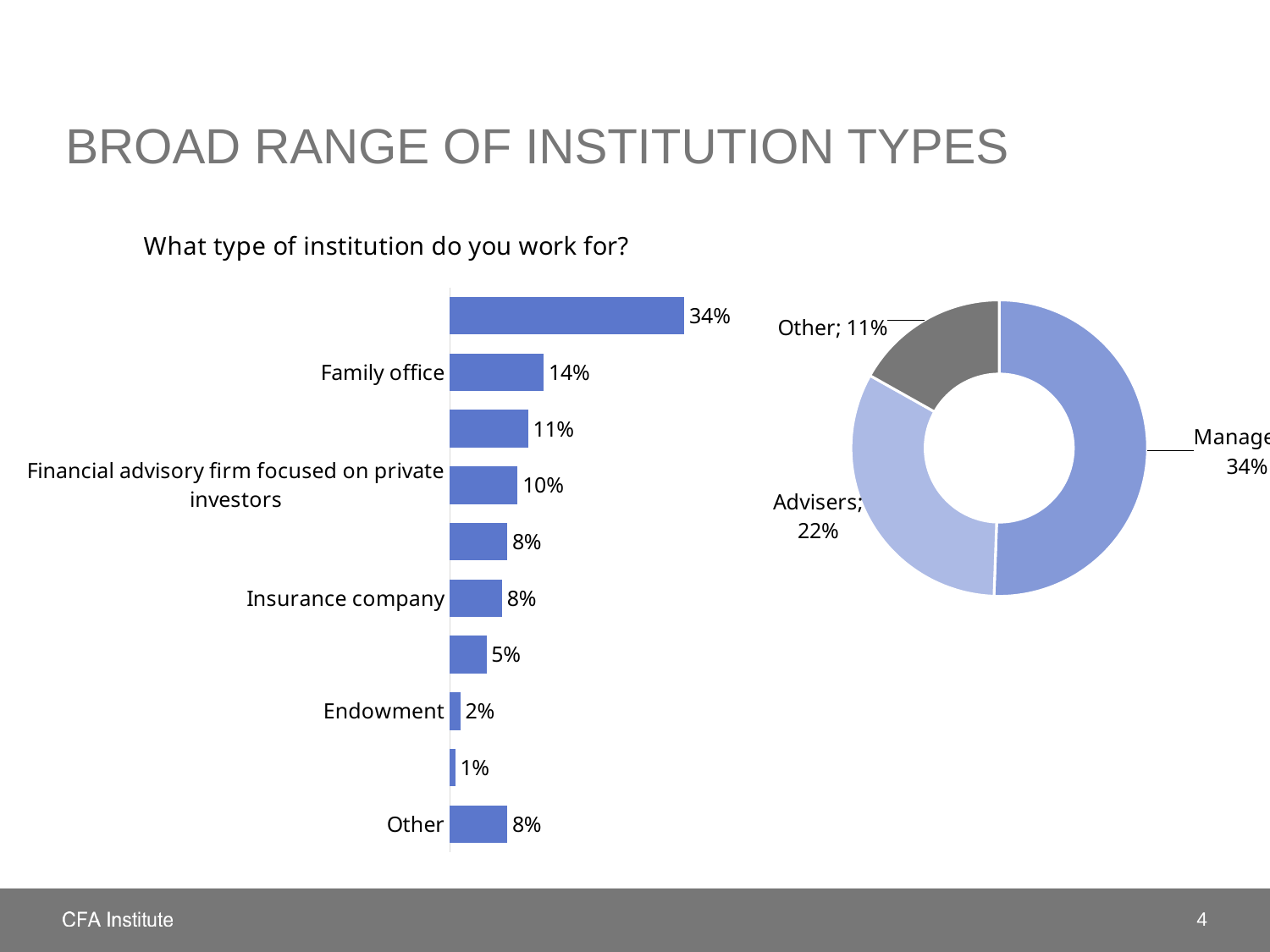
In the bar chart on the left, which is larger: Family office or Insurance company? Family office In the doughnut chart on the right, which is larger: Advisers or Other? Advisers In the doughnut chart on the right, what percentage is shown for Advisers? 22% In the bar chart on the left, what percentage is shown for Family office? 14% In the bar chart on the left, what percentage is shown for Financial advisory firm focused on private investors? 10% In the bar chart on the left, what percentage is shown for Insurance company? 8% In the bar chart on the left, what is the smallest value shown on any bar? 1% How many bars are plotted in the bar chart on the left? 10 In the bar chart on the left, how many percentage points higher is Family office than Endowment? 12 percentage points What kind of chart is the chart on the left of the slide? Bar chart In the bar chart on the left, what percentage is shown for Endowment? 2% In the bar chart on the left, what is the largest value shown on any bar? 34%